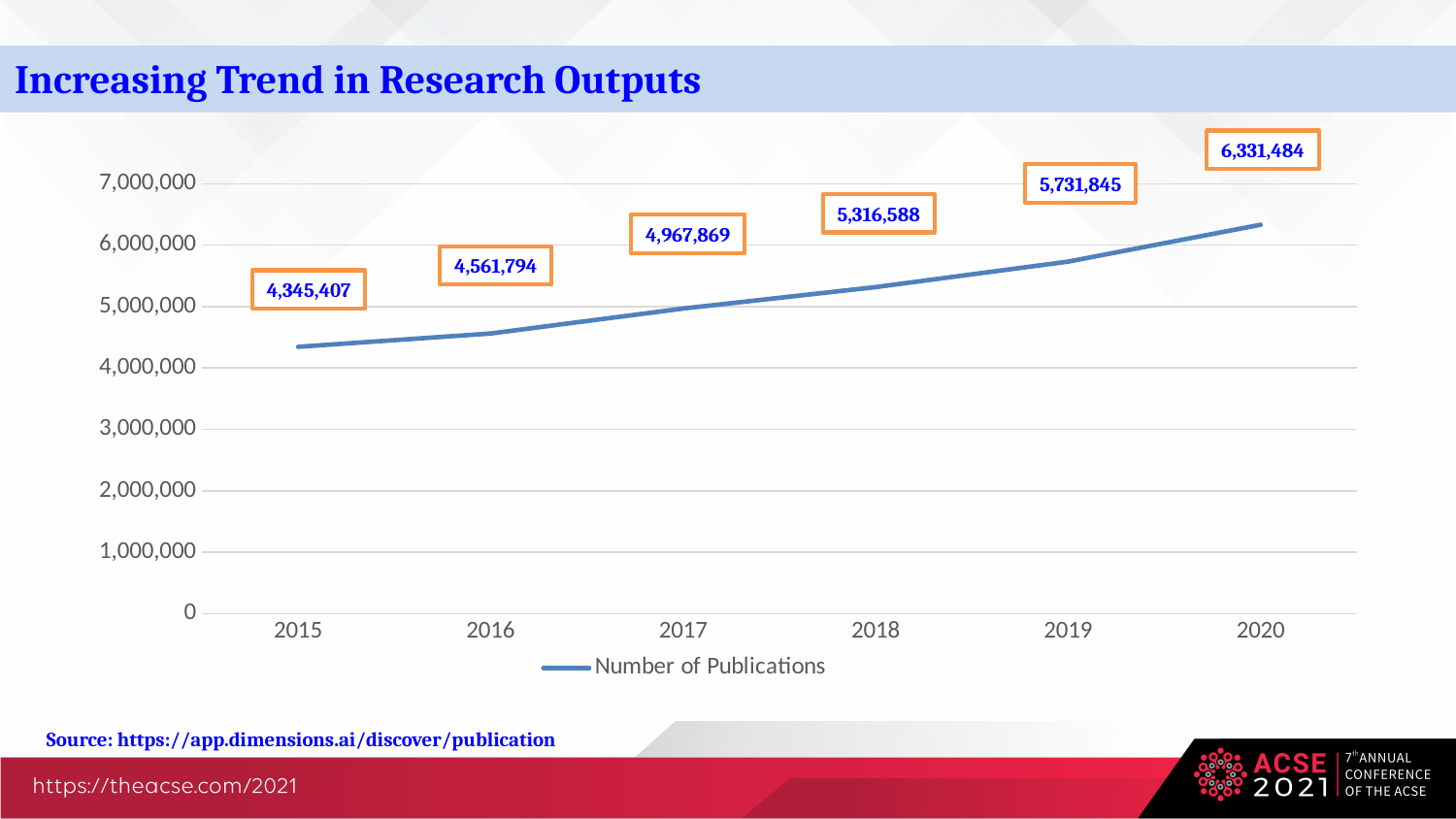
Which year has the highest number of publications? 2020 What is the difference in the number of publications between 2019 and 2018? 415,257 What is the number of publications in 2015? 4,345,407 What is the number of publications in 2018? 5,316,588 Which year has more publications, 2017 or 2019? 2019 What is the difference in the number of publications between 2020 and 2015? 1,986,077 What is the number of publications in 2020? 6,331,484 How many years are plotted on the chart? 6 Does the number of publications rise or fall from 2015 to 2020? rise Is the number of publications in 2017 greater or less than 5,000,000? less What type of chart is shown on the slide? line chart Which year has the lowest number of publications? 2015